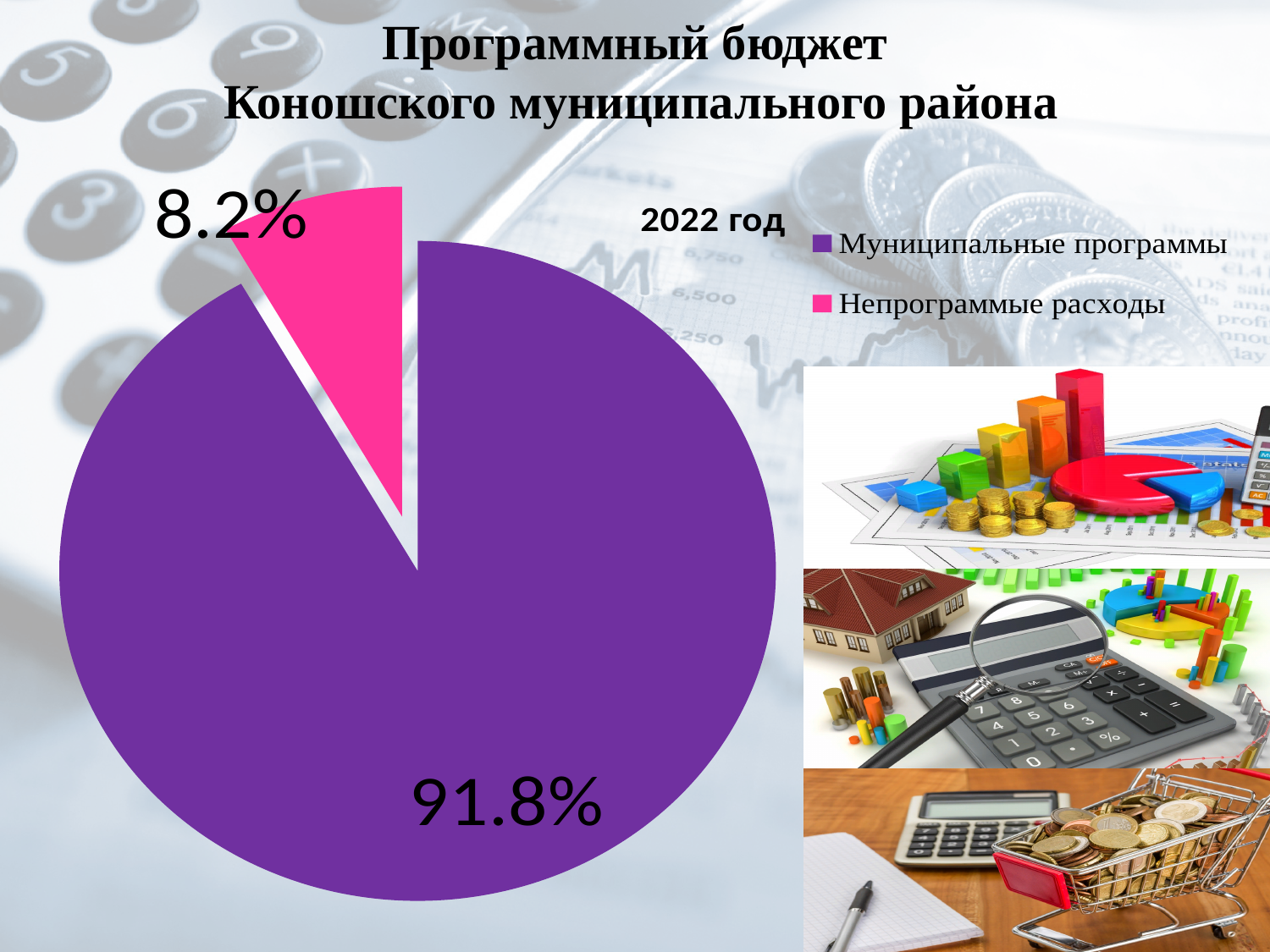
Which category has the largest slice of the pie? Муниципальные программы Which category has the smallest slice of the pie? Непрограммые расходы How many entries does the legend list? 2 What share of the pie does Муниципальные программы take? 91.8% What colour is the slice for Непрограммые расходы? Pink What kind of chart is shown on the slide? Pie chart What is the title of the chart? 2022 год What share of the pie does Непрограммые расходы take? 8.2% Which is larger: the share for Муниципальные программы or for Непрограммые расходы? Муниципальные программы What is the difference in percentage points between Муниципальные программы and Непрограммые расходы? 83.6 How many slices does the pie chart have? 2